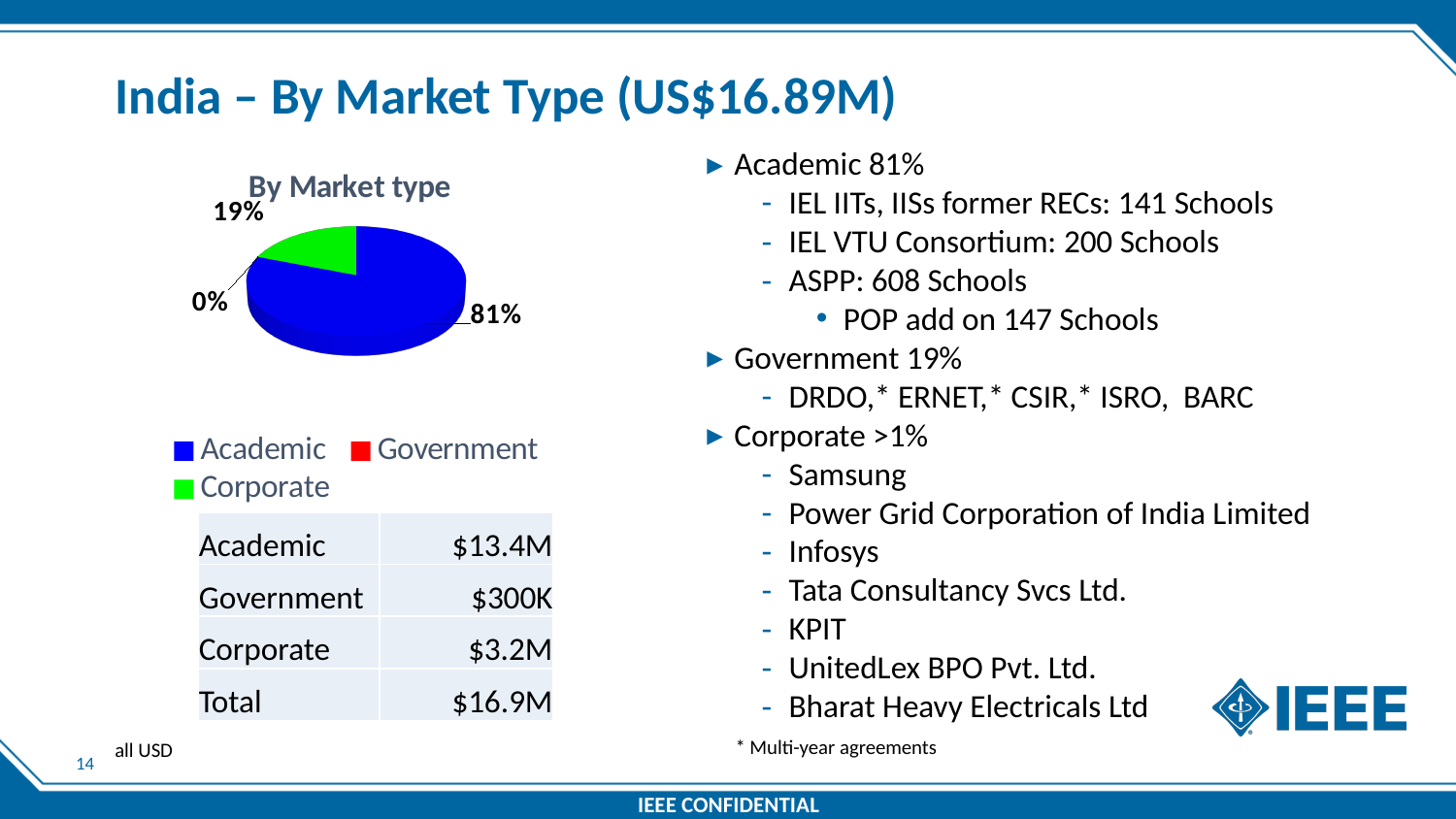
Which category has the largest slice of the pie? Academic What percentage label is shown on the green slice of the pie? 19% What is the title of the chart? By Market type Is the Academic slice larger or smaller than the green slice? larger What colour represents Academic in the chart legend? blue What share of the pie does the Academic slice represent? 81% How many entries does the chart's legend list? 3 What is the smallest percentage label shown on the pie chart? 0% Is the share of the Academic slice greater or less than 50%? greater How many slices are labelled with a percentage on the pie chart? 3 What kind of chart is shown on the slide? pie chart